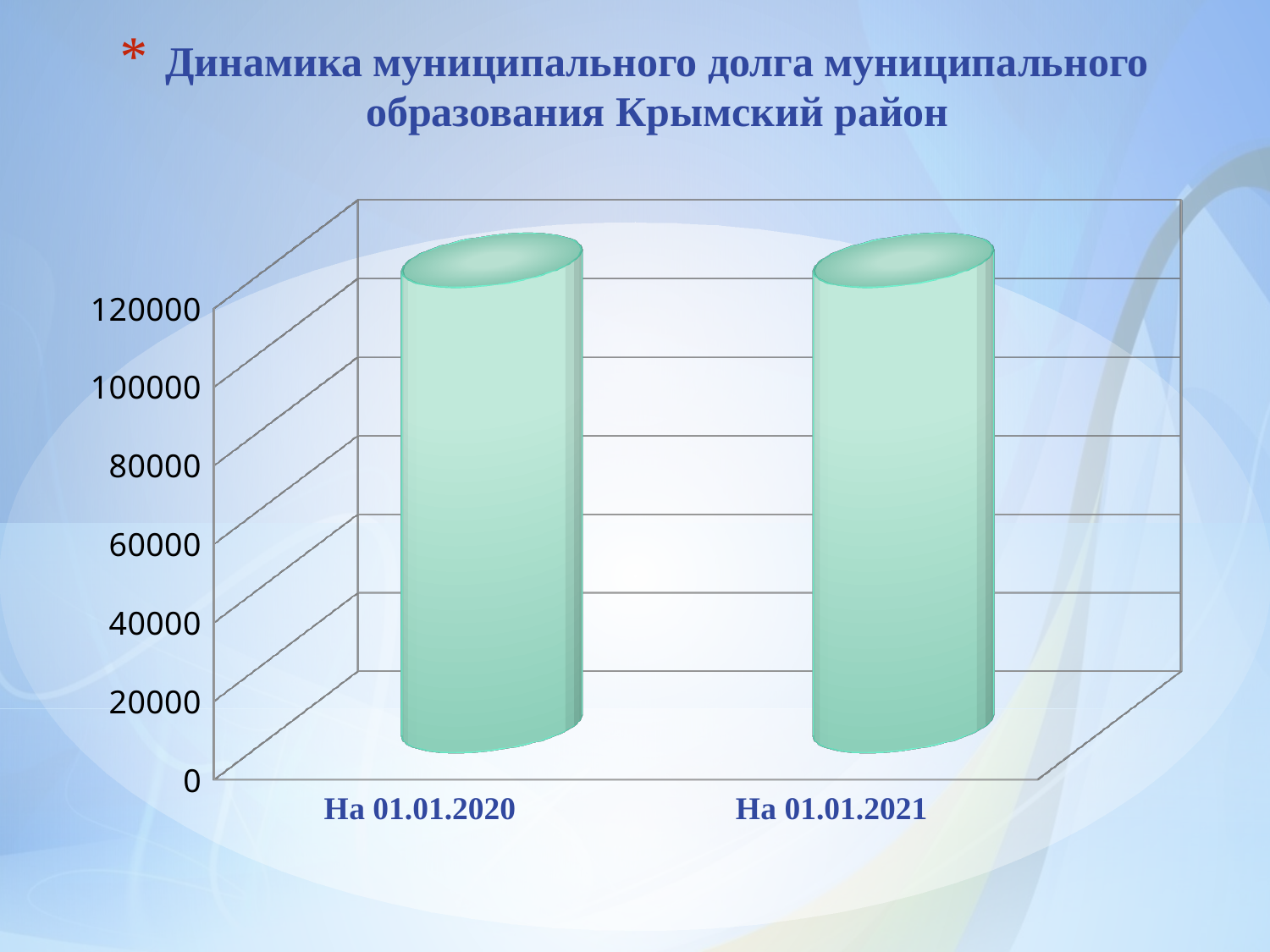
Is the value for На 01.01.2021 greater or less than 60000? greater Is the value for На 01.01.2021 greater or less than 100000? greater Is the value for На 01.01.2020 greater or less than 100000? greater What are the two category labels on the x axis of the chart? На 01.01.2020 and На 01.01.2021 How many categories (bars) does the chart show? 2 What is the title of the chart on the slide? Динамика муниципального долга муниципального образования Крымский район What is the highest value shown on the vertical axis of the chart? 120000 What kind of chart is shown on the slide? Bar chart